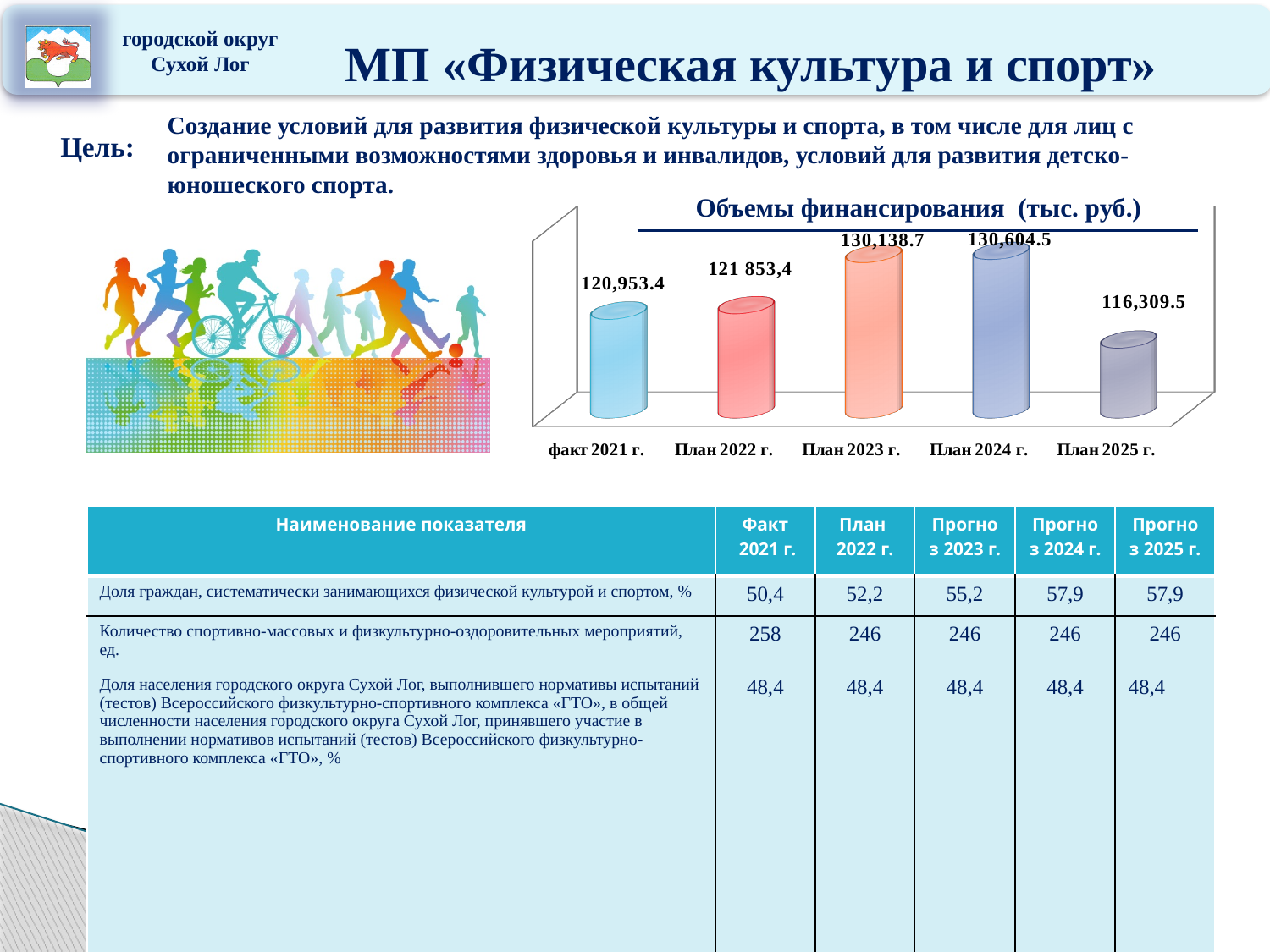
What is the value for План 2023 г. in the Объемы финансирования chart? 130,138.7 What is the difference between the values for План 2024 г. and План 2025 г. in the Объемы финансирования chart? 14,295.0 Which category has the highest value in the Объемы финансирования chart? План 2024 г. What is the title of the chart on the slide? Объемы финансирования (тыс. руб.) What is the value for факт 2021 г. in the Объемы финансирования chart? 120,953.4 What is the value for План 2025 г. in the Объемы финансирования chart? 116,309.5 How many categories are shown in the Объемы финансирования chart? 5 Which category has the lowest value in the Объемы финансирования chart? План 2025 г. What kind of chart is the Объемы финансирования chart? Bar chart What is the difference between the values for План 2023 г. and факт 2021 г. in the Объемы финансирования chart? 9,185.3 What is the value for План 2024 г. in the Объемы финансирования chart? 130,604.5 Which is larger in the Объемы финансирования chart: the value for План 2022 г. or the value for План 2025 г.? План 2022 г.